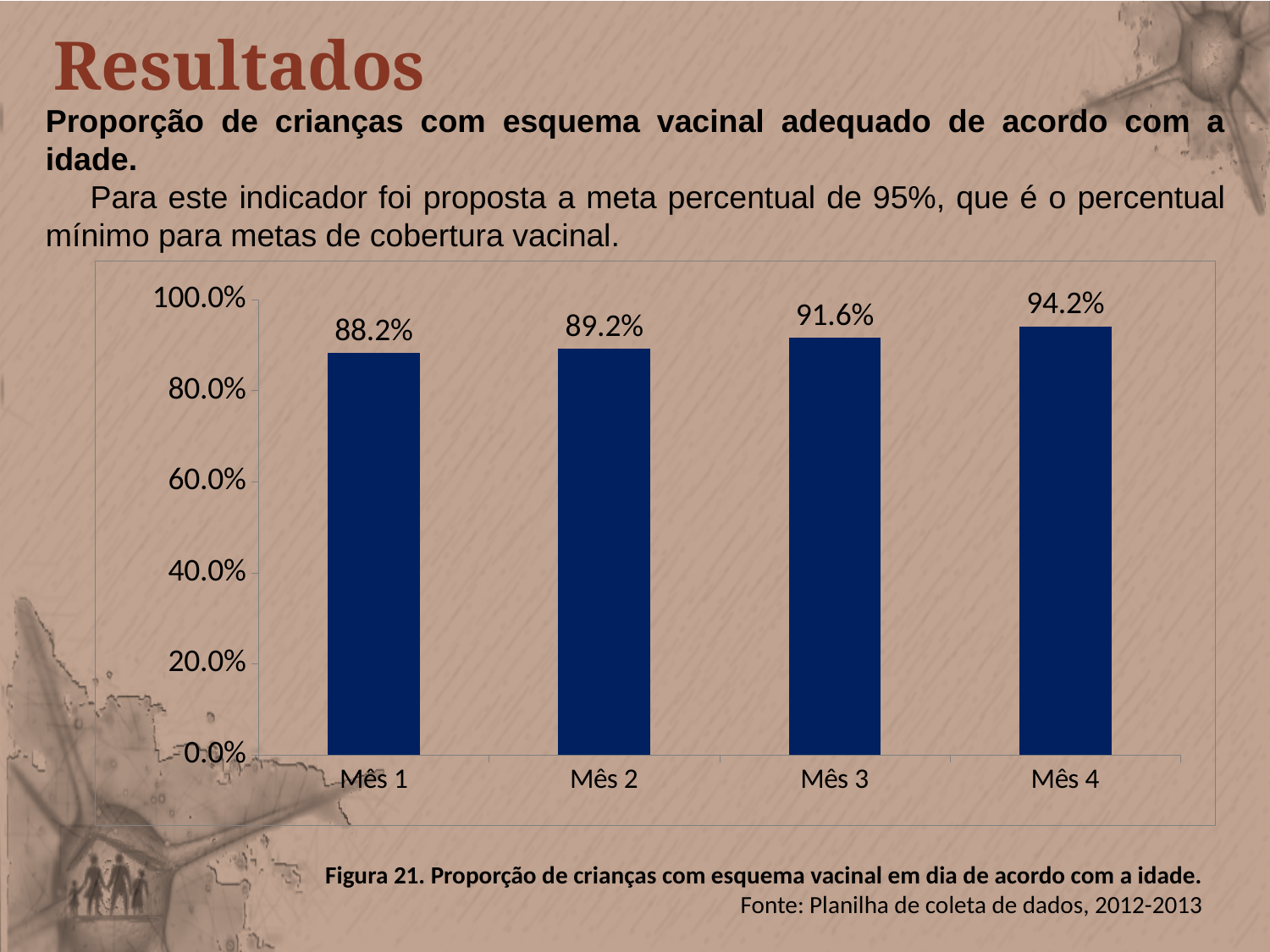
What is the value for Mês 3? 91.6% How many months are shown on the x axis? 4 Which month has the lowest value? Mês 1 What is the difference between the values for Mês 4 and Mês 1? 6.0% Is the value for Mês 2 greater or less than 80.0%? greater What kind of chart is shown on the slide? bar chart Which month has the highest value? Mês 4 Do the values rise or fall from Mês 1 to Mês 4? rise What is the difference between the values for Mês 2 and Mês 1? 1.0% What is the value for Mês 1? 88.2% Which is larger, the value for Mês 3 or the value for Mês 2? Mês 3 What is the value for Mês 4? 94.2%